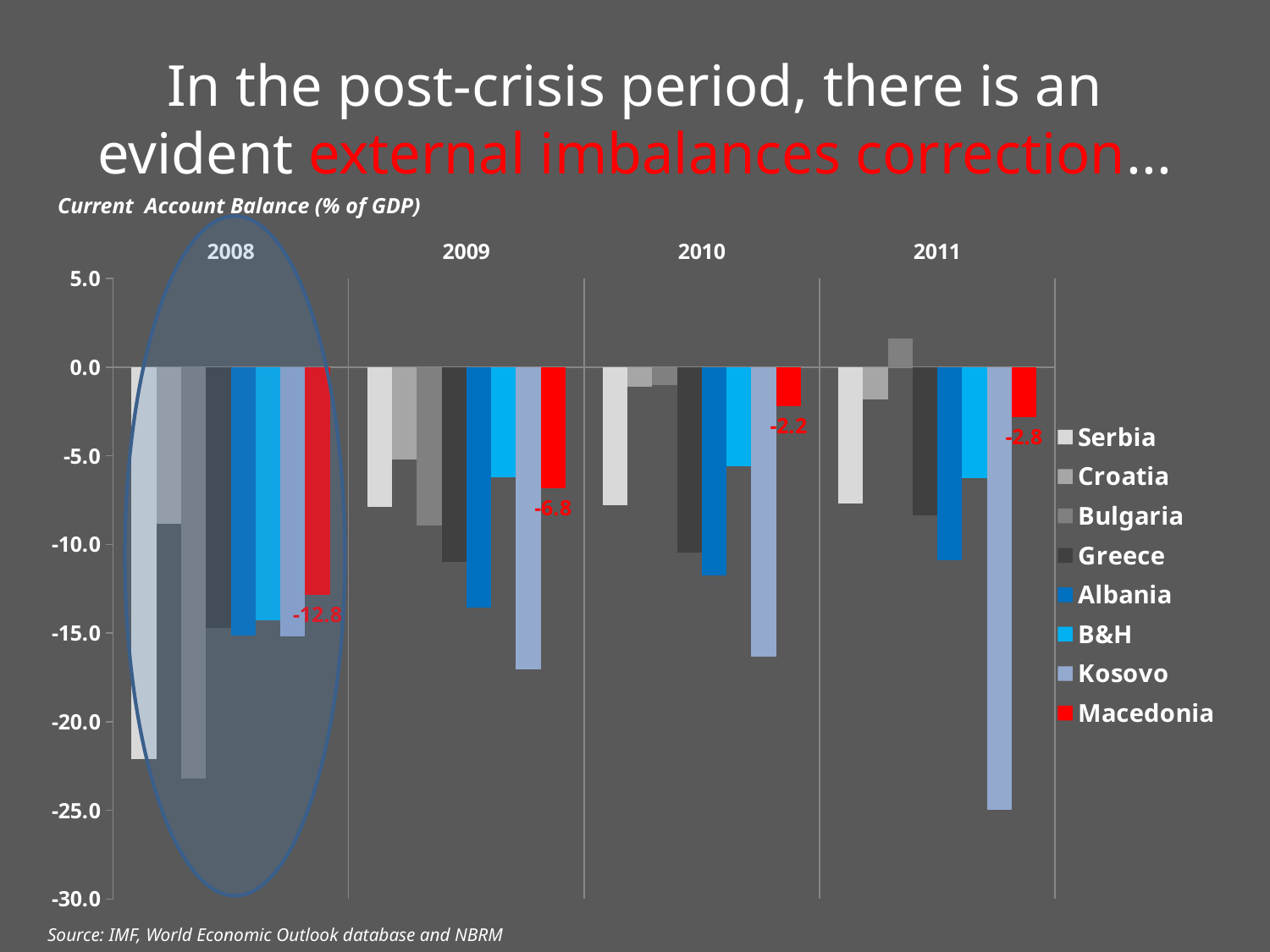
Do Macedonia's values rise or fall from 2008 to 2010? rise Is the value for Kosovo in 2011 greater or less than -20.0? less Which country has the lowest value in 2011? Kosovo By how much did Macedonia's value change between 2008 and 2009? 6.0 What is the Current Account Balance value for Macedonia in 2008? -12.8 What is the Current Account Balance value for Macedonia in 2010? -2.2 What is the Current Account Balance value for Macedonia in 2011? -2.8 Which is larger, Macedonia's value in 2010 or in 2011? 2010 How many countries does the legend list? 8 What is the Current Account Balance value for Macedonia in 2009? -6.8 How many years are shown on the x axis? 4 What kind of chart is shown on the slide? bar chart